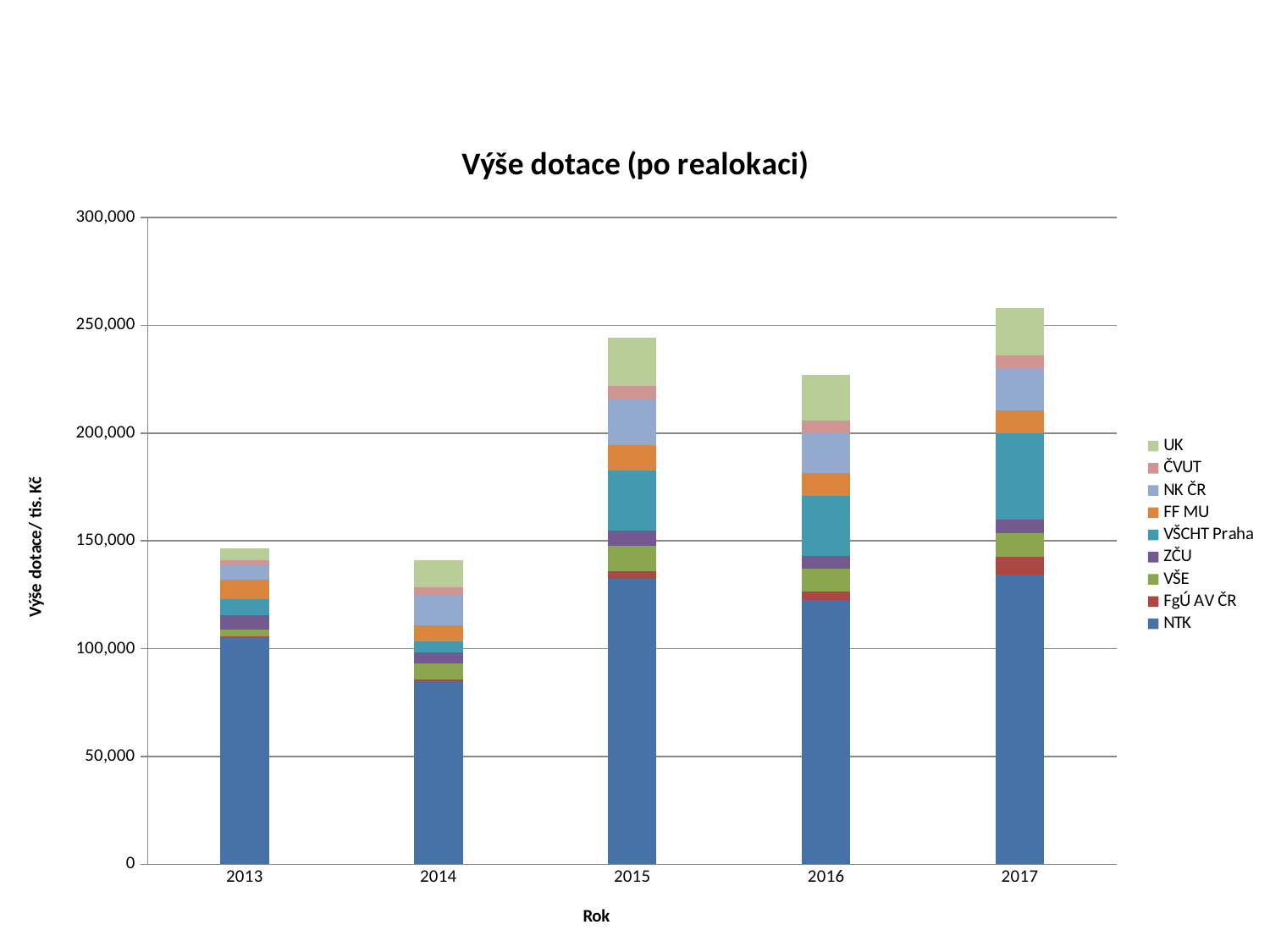
Is the NTK value for 2017 greater or less than 100,000? greater What is the title of the x axis of the chart? Rok What kind of chart is shown on the slide? Stacked bar chart Is the total stacked value for 2014 greater or less than 150,000? less How many years are shown on the x axis of the chart? 5 Which year has the highest total stacked bar? 2017 What is the title of the chart? Výše dotace (po realokaci) Does the total stacked value rise or fall from 2014 to 2015? rise Is the NTK value for 2014 greater or less than 100,000? less How many series does the legend of the chart list? 9 Which year has the larger total stacked bar, 2015 or 2016? 2015